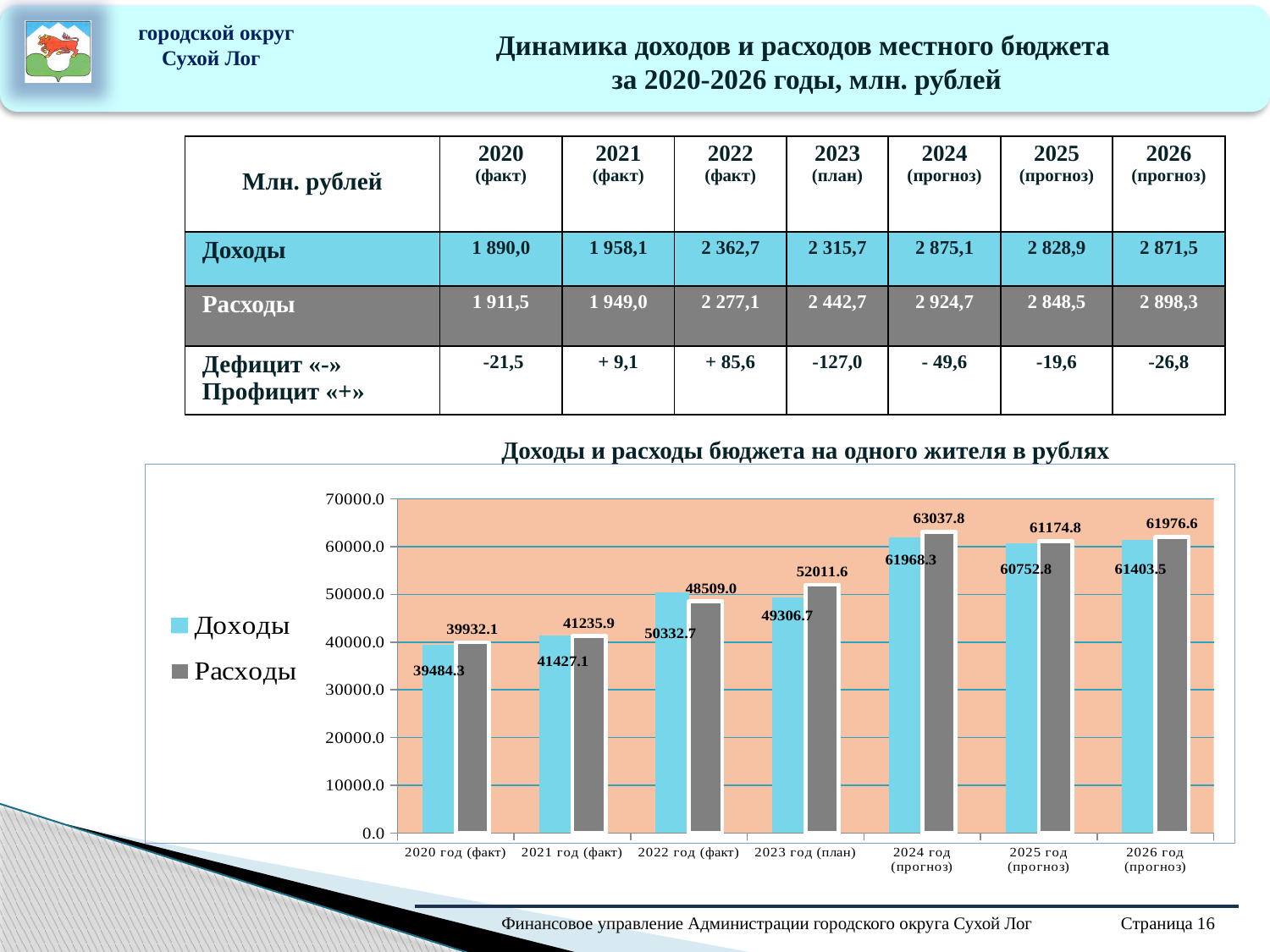
What kind of chart is shown on the slide? bar chart What is the value for Доходы in 2026 год (прогноз) on the chart? 61403.5 Is the Доходы value for 2021 год (факт) greater or less than 50000.0? less How many series does the chart legend list? 2 What is the difference between Доходы and Расходы in 2022 год (факт) on the chart? 1823.7 What is the value for Доходы in 2022 год (факт) on the chart? 50332.7 What is the difference between Расходы and Доходы in 2023 год (план) on the chart? 2704.9 What is the value for Расходы in 2024 год (прогноз) on the chart? 63037.8 In which year is the Расходы value highest on the chart? 2024 год (прогноз) In which year is the Доходы value lowest on the chart? 2020 год (факт) In 2022 год (факт), which is larger on the chart: Доходы or Расходы? Доходы How many years are shown on the x axis of the chart? 7